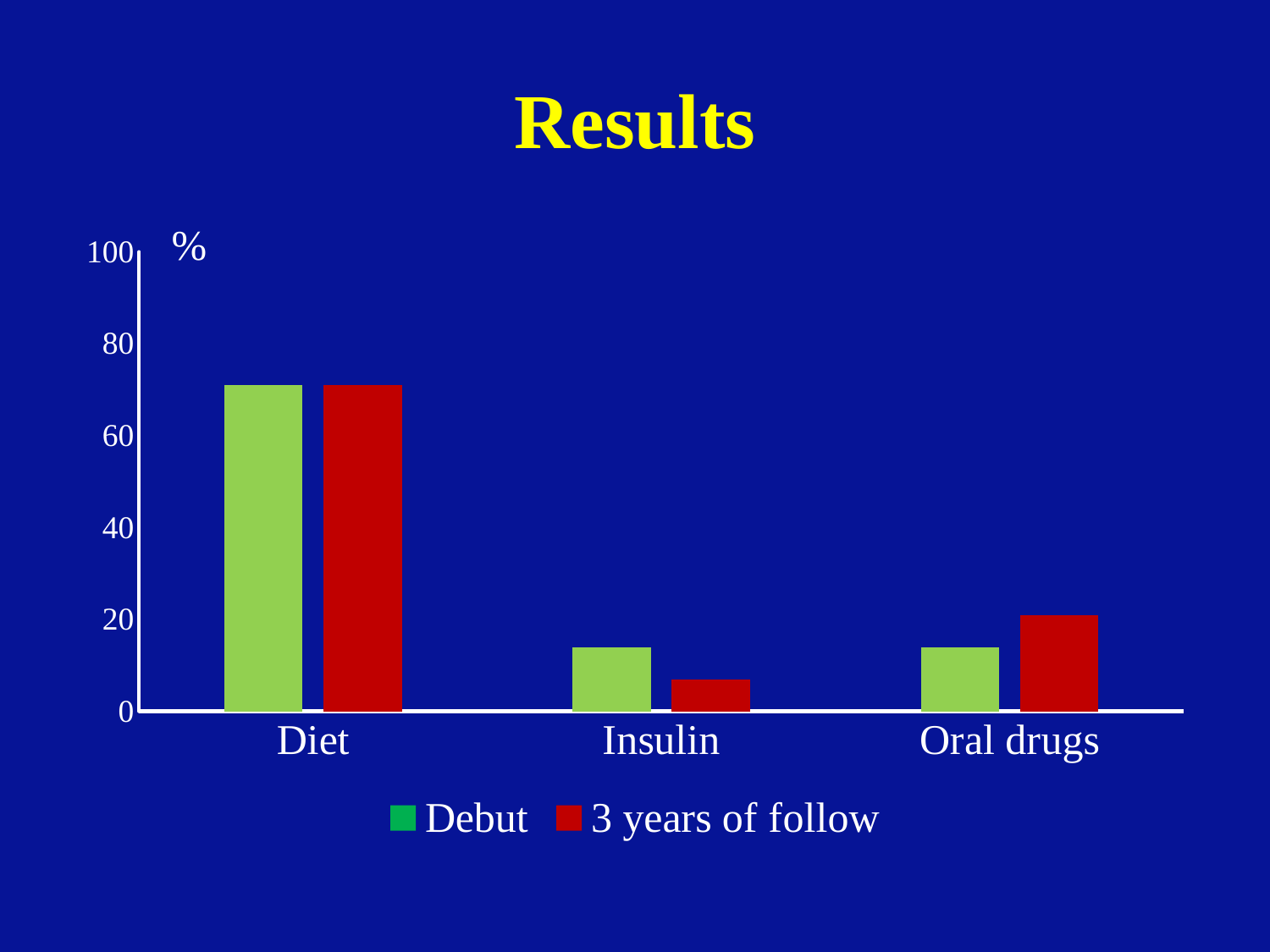
For Insulin, which series has the larger value, 'Debut' or '3 years of follow'? Debut Which colour represents the 'Debut' series in the chart? green Which category has the highest value for the 'Debut' series? Diet Is the '3 years of follow' value for Diet greater or less than 80? less Which category has the lowest value for the '3 years of follow' series? Insulin How many categories are shown on the x axis of the chart? 3 For Oral drugs, which series has the larger value, 'Debut' or '3 years of follow'? 3 years of follow What kind of chart is shown on the slide? bar chart How many series does the chart's legend list? 2 What is the title of the slide containing the chart? Results Is the 'Debut' value for Diet greater or less than 60? greater Is the '3 years of follow' value for Insulin greater or less than 20? less